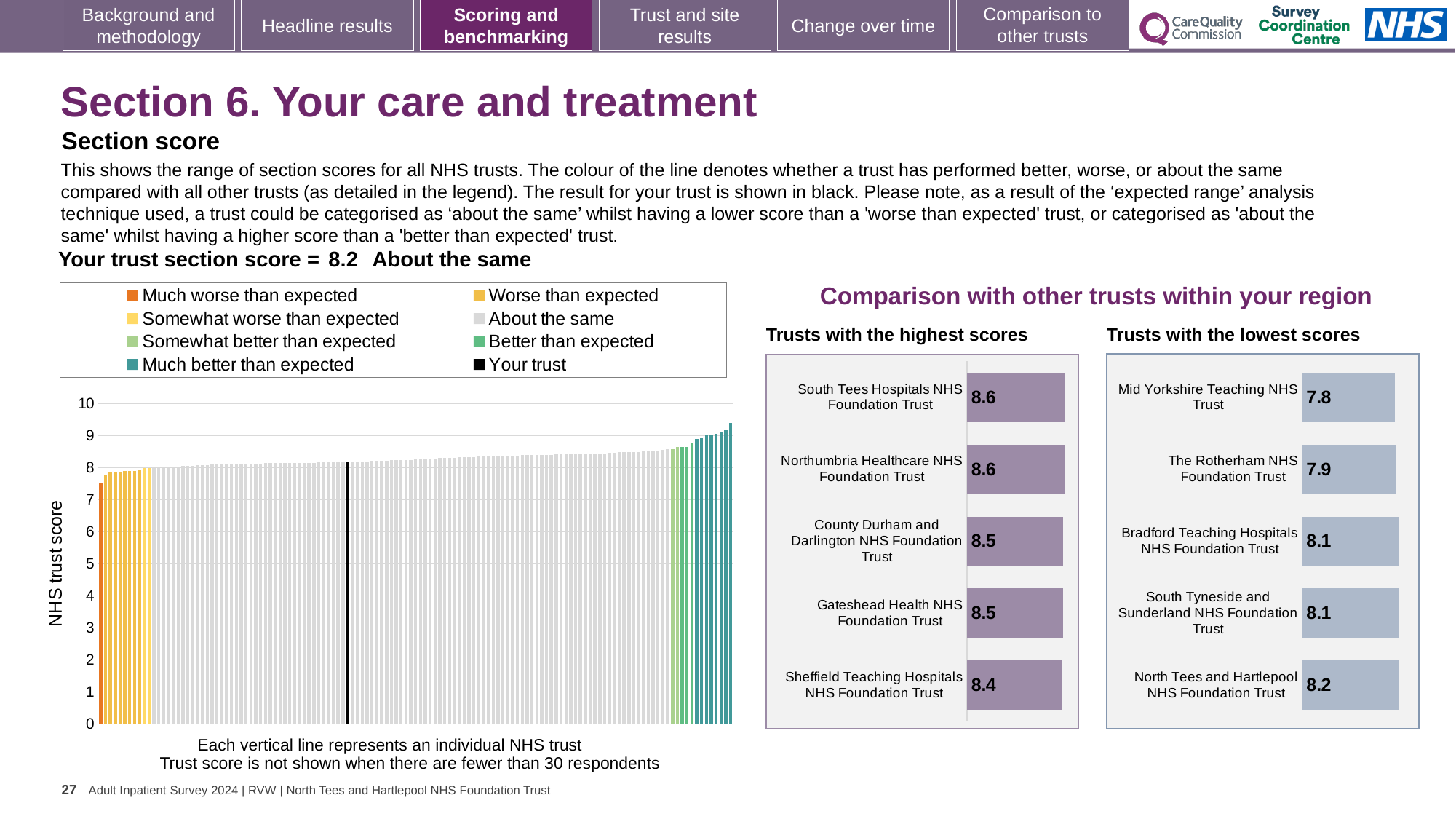
In the 'Trusts with the lowest scores' chart, what is the score for Mid Yorkshire Teaching NHS Trust? 7.8 In the 'Trusts with the highest scores' chart, what is the score for Sheffield Teaching Hospitals NHS Foundation Trust? 8.4 In the 'Trusts with the highest scores' chart, what is the difference between the scores of South Tees Hospitals NHS Foundation Trust and Sheffield Teaching Hospitals NHS Foundation Trust? 0.2 In the 'Trusts with the highest scores' chart, which has the larger score: Gateshead Health NHS Foundation Trust or Sheffield Teaching Hospitals NHS Foundation Trust? Gateshead Health NHS Foundation Trust In the NHS trust score chart on the left, do the values rise or fall from left to right along the x axis? Rise In the 'Trusts with the lowest scores' chart, which trust has the lowest score? Mid Yorkshire Teaching NHS Trust In the 'Trusts with the lowest scores' chart, which trust has the highest score? North Tees and Hartlepool NHS Foundation Trust How many entries does the legend of the NHS trust score chart on the left list? 8 What kind of chart is the NHS trust score chart on the left of the slide? Bar chart How many trusts are listed in the 'Trusts with the lowest scores' chart? 5 In the 'Trusts with the lowest scores' chart, what is the difference between the scores of North Tees and Hartlepool NHS Foundation Trust and Mid Yorkshire Teaching NHS Trust? 0.4 In the 'Trusts with the highest scores' chart, what is the score for South Tees Hospitals NHS Foundation Trust? 8.6